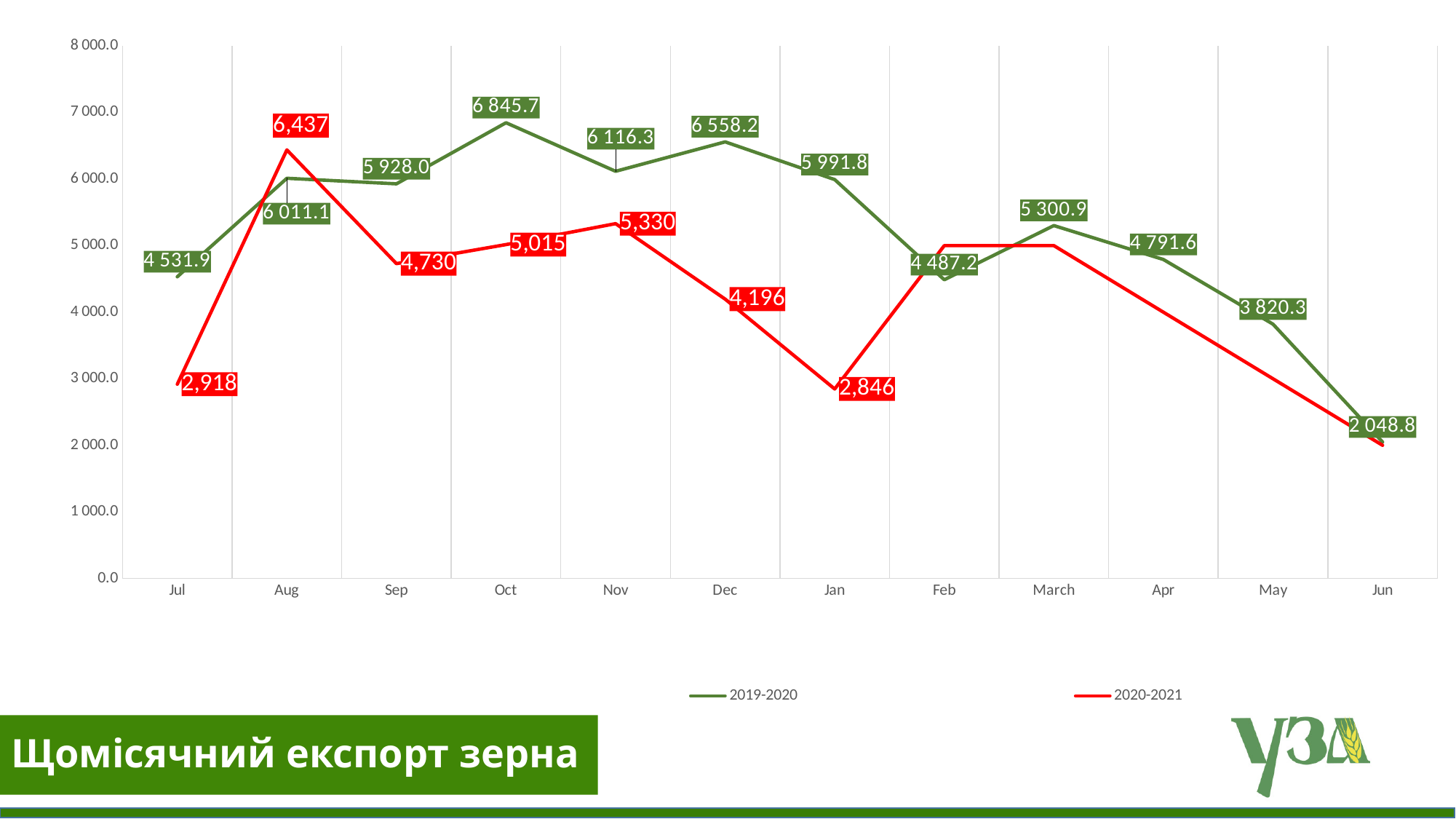
Which month has the highest value in the 2020-2021 series? Aug What is the value for Aug in the 2020-2021 series? 6,437 Which month has the lowest value in the 2019-2020 series? Jun Which month has the highest value in the 2019-2020 series? Oct How many series does the legend list? 2 What is the difference between the 2020-2021 and 2019-2020 values for Aug? 425.9 Is the value for May in the 2020-2021 series greater or less than 4 000.0? less What kind of chart is shown on the slide? line chart What is the value for Oct in the 2019-2020 series? 6 845.7 What is the value for Jan in the 2020-2021 series? 2,846 In Jul, which series has the larger value, 2019-2020 or 2020-2021? 2019-2020 How many months are shown on the x axis? 12